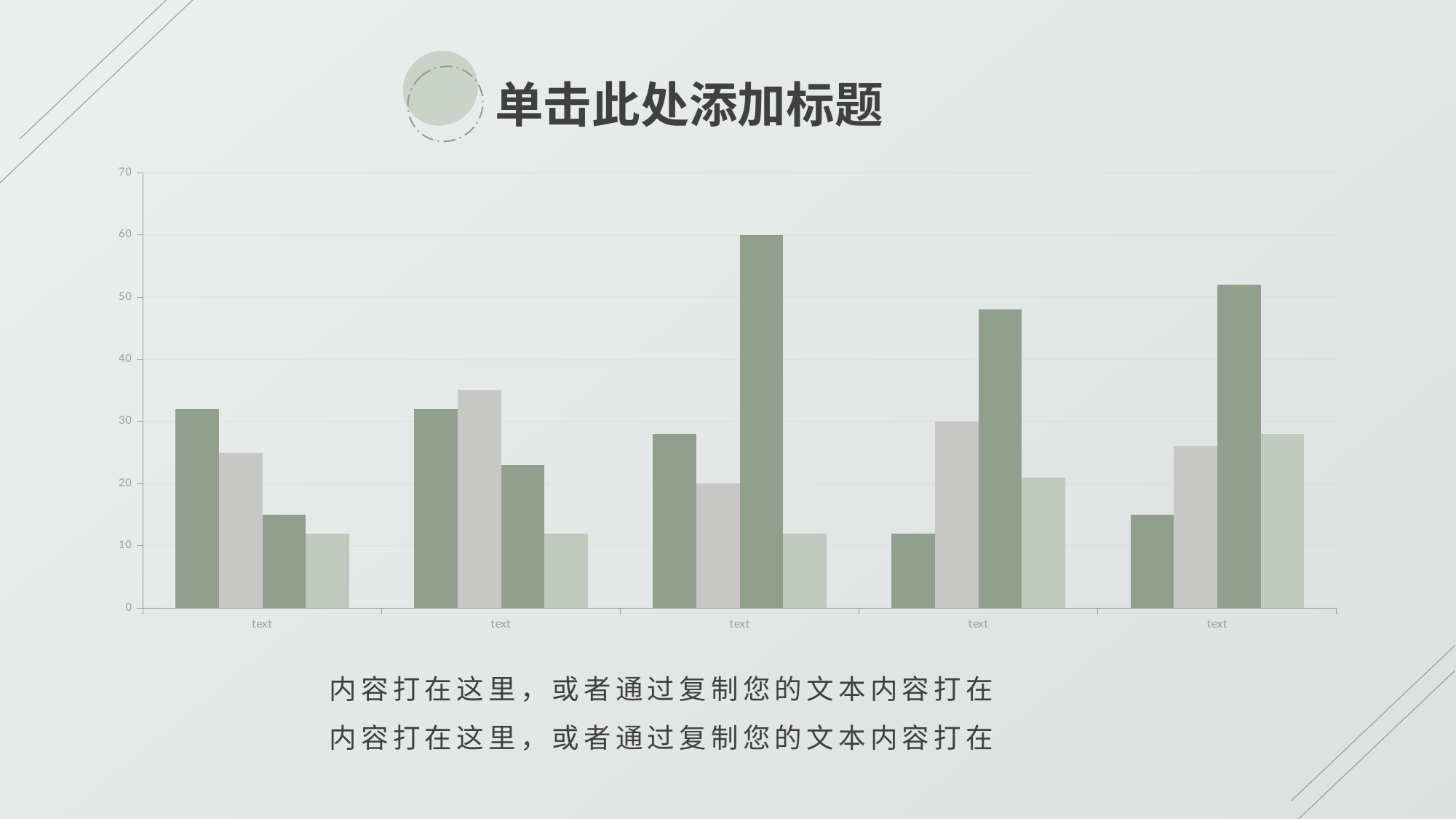
What kind of chart is shown on the slide? bar chart In the third category group, which is taller: the first bar or the third bar? the third bar Which category group contains the tallest bar in the chart? the third group What is the highest value shown on the chart's y axis? 70 Is the value of the first bar in the fourth category group greater or less than 20? less Is the value of the fourth (rightmost) bar in the first category group greater or less than 20? less How many bars are there in each category group of the chart? 4 Is the value of the tallest bar in the third category group greater or less than 50? greater How many category groups are shown along the x axis of the chart? 5 What label is shown under each category group on the x axis? text